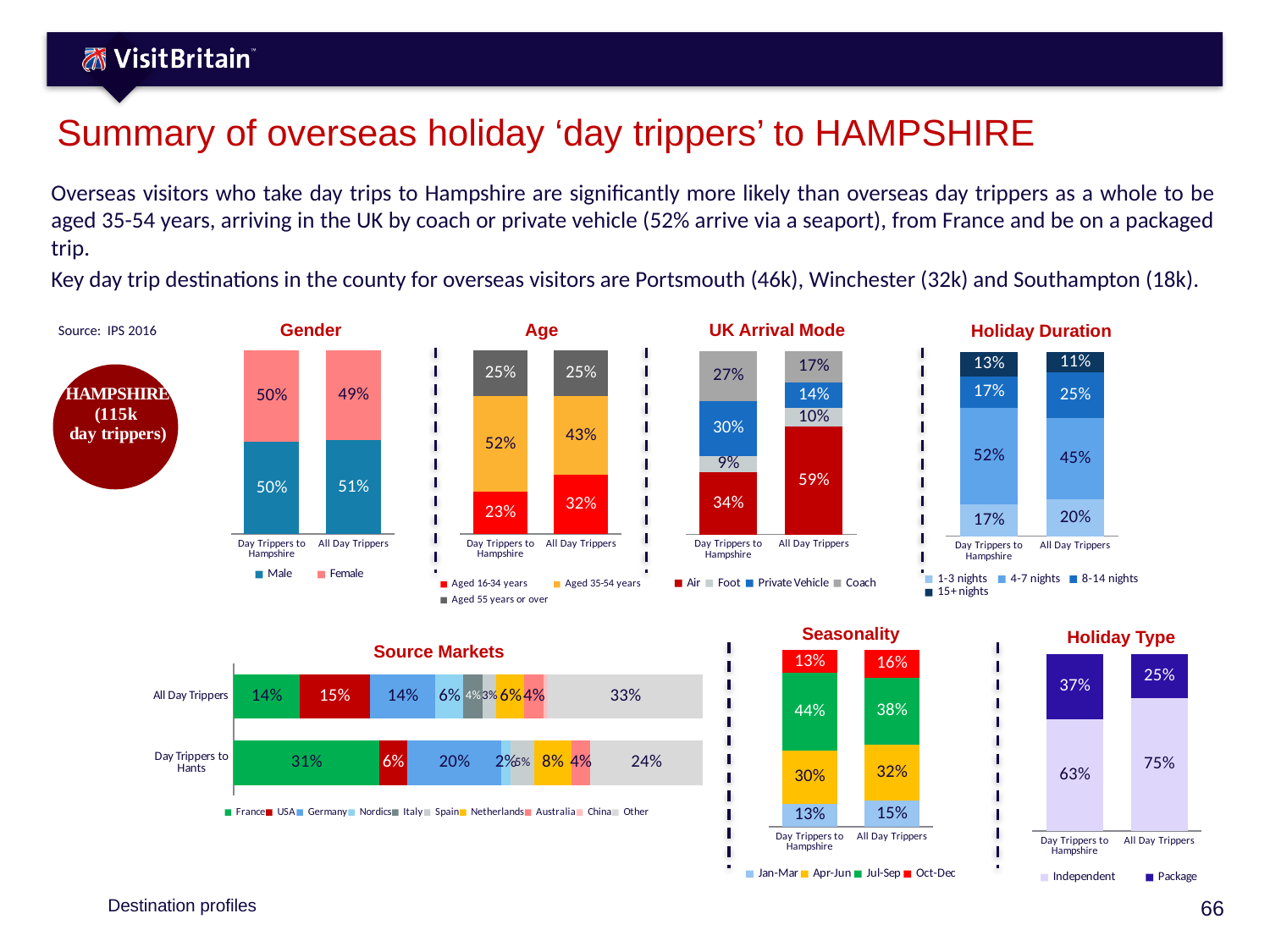
In the UK Arrival Mode chart, what percentage of All Day Trippers arrive by Air? 59% In the Source Markets chart, which group has the larger share from Germany: All Day Trippers or Day Trippers to Hants? Day Trippers to Hants In the UK Arrival Mode chart, which arrival mode has the smallest share for Day Trippers to Hampshire? Foot How many series does the legend of the Holiday Duration chart list? 4 In the Holiday Type chart, what is the difference between the Package share for Day Trippers to Hampshire and for All Day Trippers? 12% In the Holiday Duration chart, what share of Day Trippers to Hampshire stay 4-7 nights? 52% In the Age chart, what share of Day Trippers to Hampshire are aged 35-54 years? 52% In the Source Markets chart, what percentage of Day Trippers to Hants come from France? 31% What type of chart is the Gender chart? Stacked bar chart In the Gender chart, what is the total of the Male and Female shares for All Day Trippers? 100% How many source markets does the legend of the Source Markets chart list? 10 In the Seasonality chart, which quarter has the largest share for Day Trippers to Hampshire? Jul-Sep